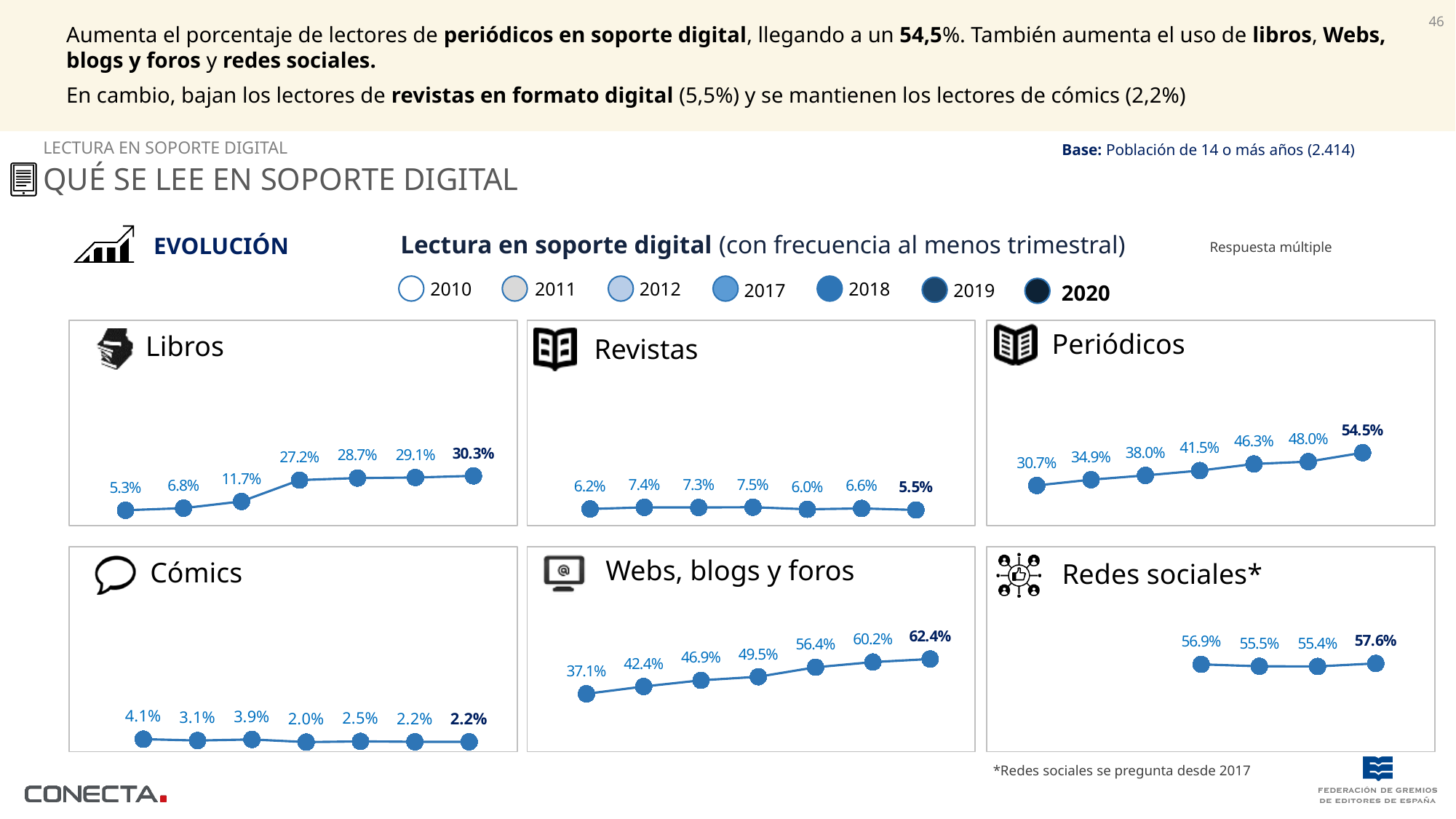
In the Libros chart, what is the value for 2020? 30.3% In the Webs, blogs y foros chart, which is larger, the value for 2018 or the value for 2012? 2018 In the Periódicos chart, what is the difference between the 2020 value and the 2019 value? 6.5% What kind of chart is used in the Libros panel? line chart In the Cómics chart, which year has the lowest value? 2017 How many data points are plotted in the Redes sociales chart? 4 In the Periódicos chart, what is the value for 2010? 30.7% In the Periódicos chart, do the values rise or fall from 2010 to 2020? rise According to the footnote, from which year has Redes sociales been asked about? 2017 In the Webs, blogs y foros chart, what is the value for 2010? 37.1% How many years does the legend at the top of the slide list? 7 In the Revistas chart, which year has the highest value? 2017